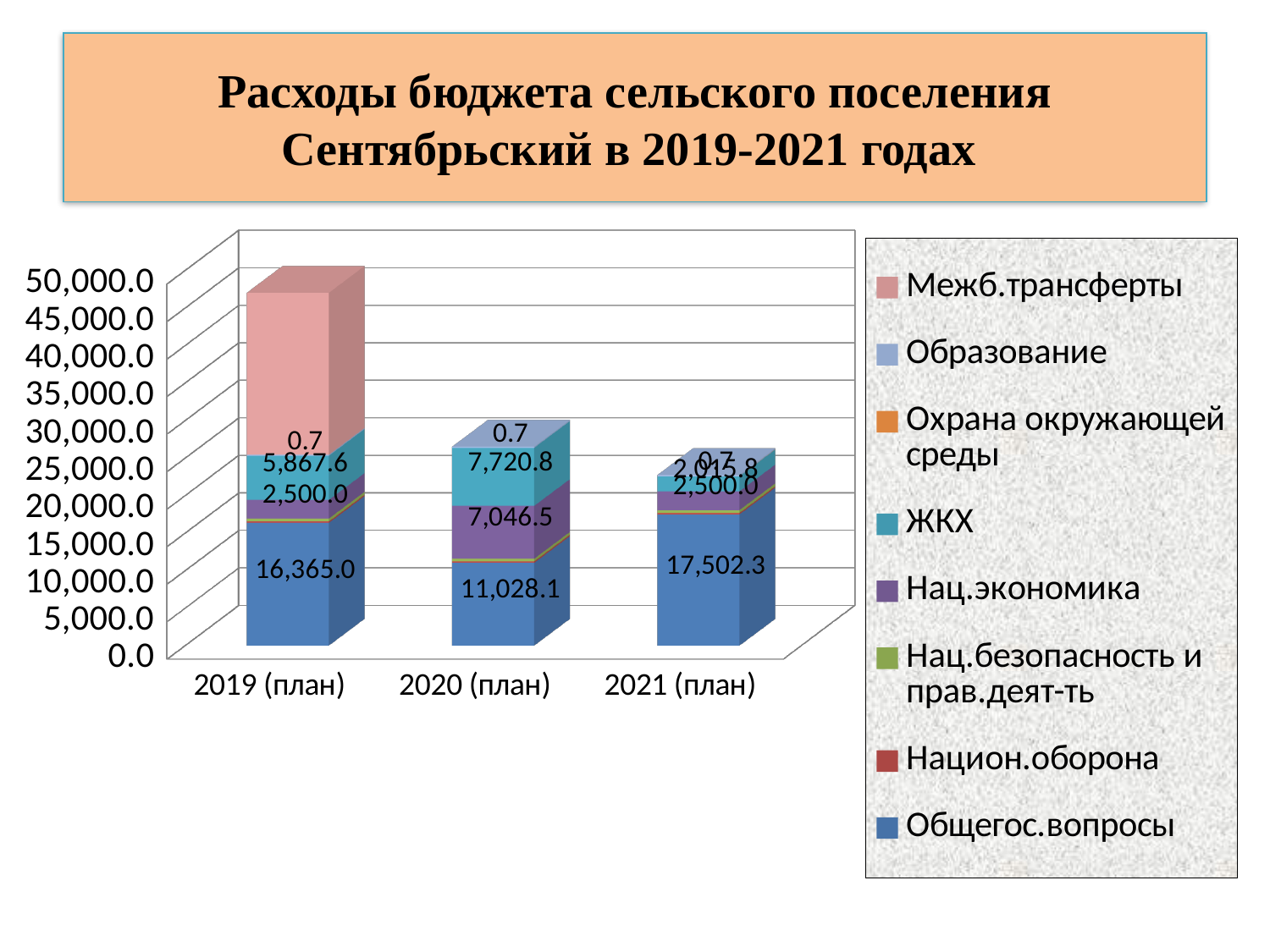
What is the value for Общегос.вопросы in 2021 (план)? 17,502.3 What kind of chart is shown on the slide? Stacked bar chart What is the value for Нац.экономика in 2020 (план)? 7,046.5 In which year is the value for Общегос.вопросы the lowest? 2020 (план) In which year is the value for Общегос.вопросы the highest? 2021 (план) What is the value for Общегос.вопросы in 2020 (план)? 11,028.1 What is the difference between the Общегос.вопросы values for 2021 (план) and 2019 (план)? 1,137.3 Is the total height of the 2019 (план) bar greater or less than 40,000.0? greater Which year has the larger value for ЖКХ, 2019 (план) or 2020 (план)? 2020 (план) How many series does the legend list? 8 What is the value for Общегос.вопросы in 2019 (план)? 16,365.0 What is the value for ЖКХ in 2020 (план)? 7,720.8